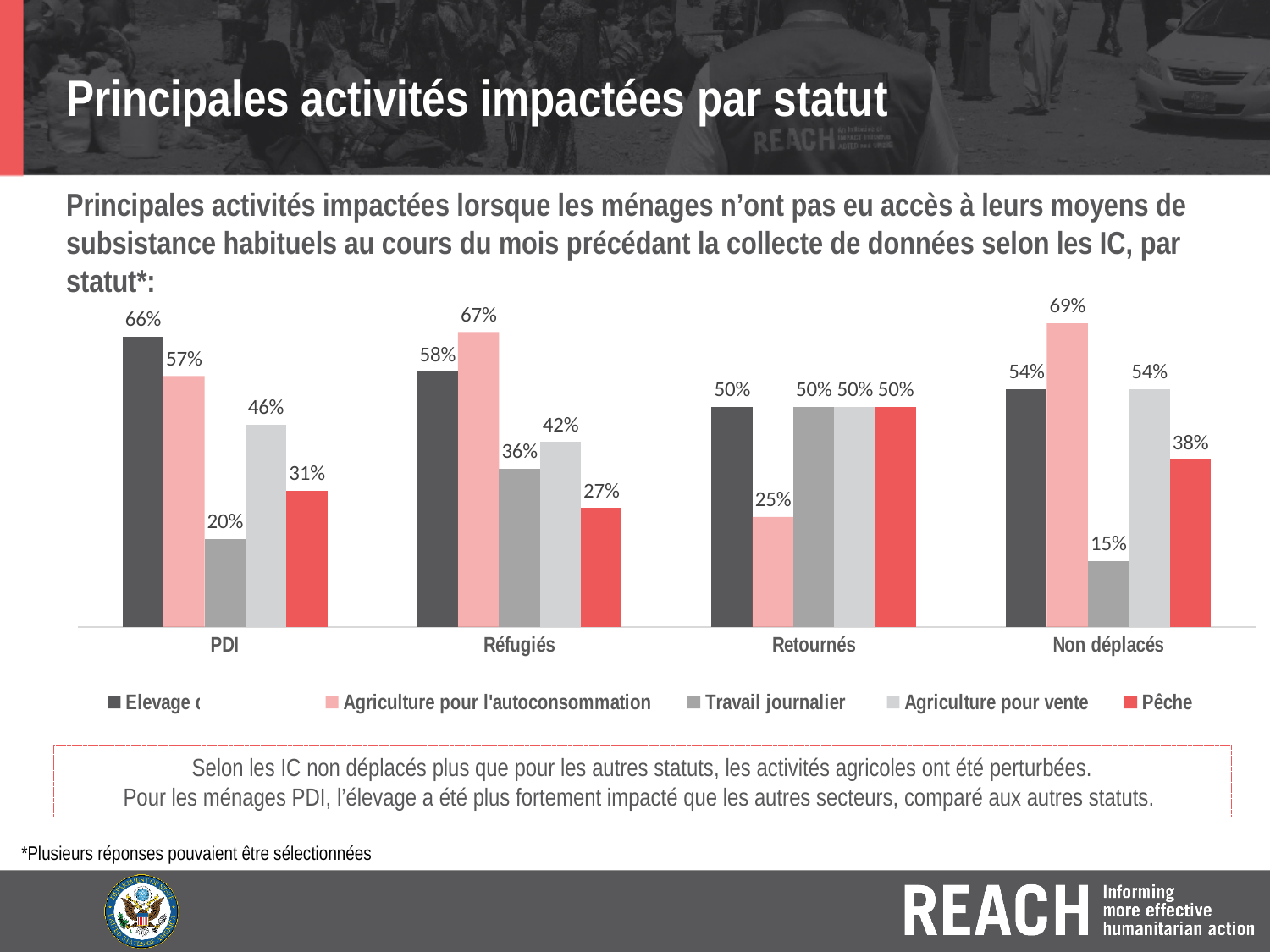
How many series does the legend list? 5 What is the value for Pêche in the Réfugiés group? 27% What kind of chart is shown on the slide? Bar chart What is the value for Agriculture pour vente in the Retournés group? 50% What is the value for Agriculture pour l'autoconsommation in the Non déplacés group? 69% Which colour represents Pêche in the chart? Red How many status groups are shown on the x axis? 4 What is the value for Travail journalier in the PDI group? 20% What is the difference between Agriculture pour l'autoconsommation and Travail journalier in the Réfugiés group? 31% Which series has the lowest value in the Non déplacés group? Travail journalier Which series has the highest value in the PDI group? Elevage Which is larger in the Retournés group: Elevage or Agriculture pour l'autoconsommation? Elevage